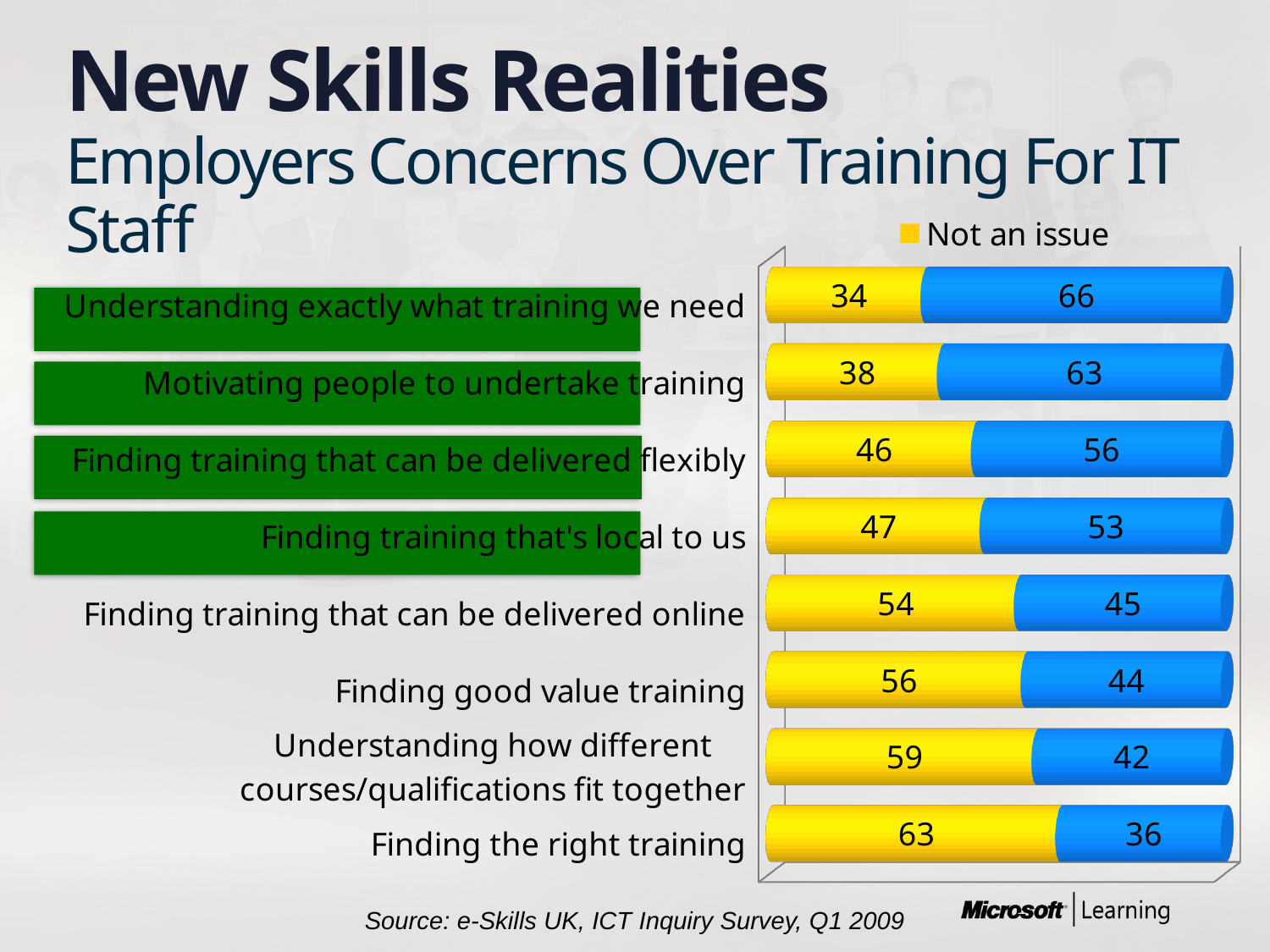
Which is larger: the "Not an issue" value for "Finding training that can be delivered online" or for "Finding training that can be delivered flexibly"? Finding training that can be delivered online What is the difference between the "Not an issue" values for "Finding the right training" and "Motivating people to undertake training"? 25 What is the "Not an issue" value for "Finding training that's local to us"? 47 How many categories are shown in the chart? 8 What is the value of the blue segment for "Understanding how different courses/qualifications fit together"? 42 What colour represents the "Not an issue" series in the chart? Yellow What is the "Not an issue" value for "Finding good value training"? 56 Which category has the lowest "Not an issue" value? Understanding exactly what training we need Which category has the highest "Not an issue" value? Finding the right training What is the value of the blue segment for "Understanding exactly what training we need"? 66 What is the total of the two segments in the bar for "Finding training that can be delivered flexibly"? 102 What kind of chart is shown on the slide? Stacked bar chart